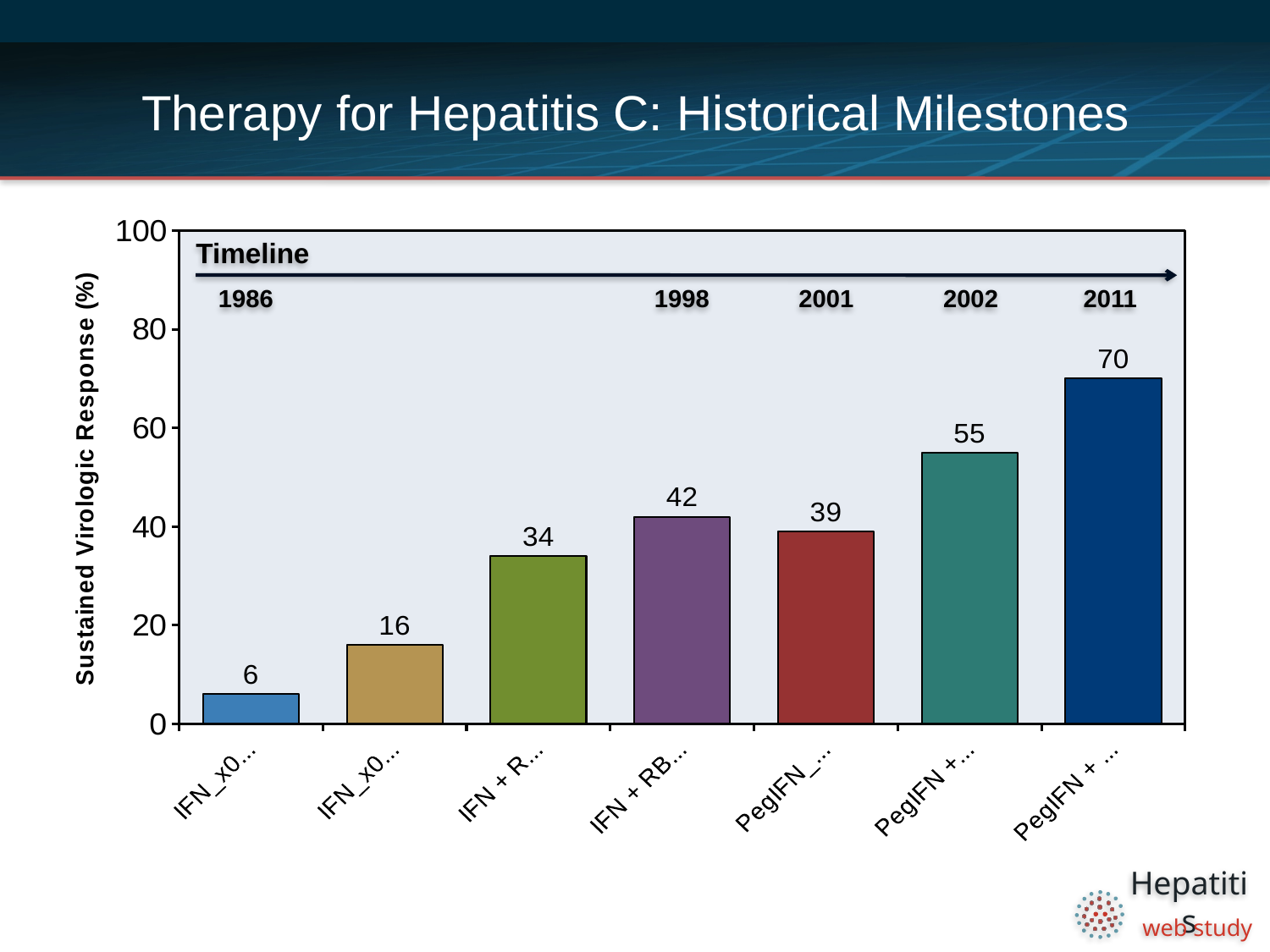
What is the value of the rightmost bar in the chart? 70 Which is larger, the fourth bar from the left or the fifth bar from the left? the fourth bar (42) How many bars are plotted in the chart? 7 What is the label on the vertical axis of the chart? Sustained Virologic Response (%) What is the value of the third bar from the left? 34 Overall, do the bar values rise or fall from left to right across the chart? rise What is the difference between the sixth bar and the fifth bar from the left? 16 Which bar has the lowest value in the chart? the leftmost bar (6) What is the difference between the rightmost bar and the leftmost bar? 64 What is the value of the fourth bar from the left? 42 What type of chart is shown on the slide? bar chart Which bar has the highest value in the chart? the rightmost bar (70)